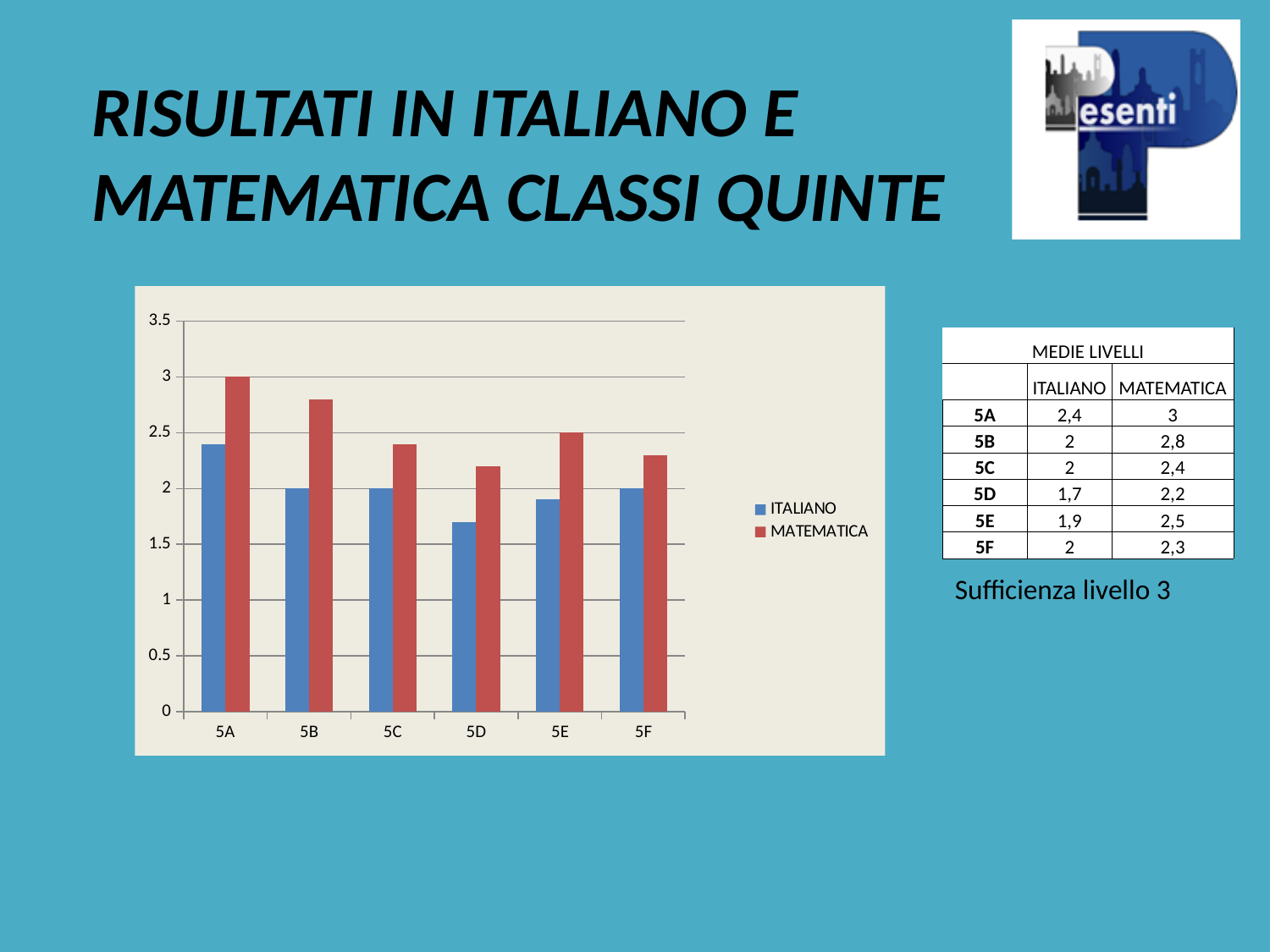
Which is larger, the MATEMATICA value for 5A or for 5B? 5A What is the difference between the MATEMATICA and ITALIANO values for class 5B? 0,8 What kind of chart is shown on the slide? bar chart Which class has the lowest ITALIANO value? 5D What is the ITALIANO value for class 5A? 2,4 Which class has the highest MATEMATICA value? 5A Is the ITALIANO value for class 5D greater or less than 2? less How many classes are shown on the x axis of the chart? 6 What is the ITALIANO value for class 5D? 1,7 How many series does the chart legend list? 2 Which colour represents the MATEMATICA series in the chart? red What is the MATEMATICA value for class 5E? 2,5